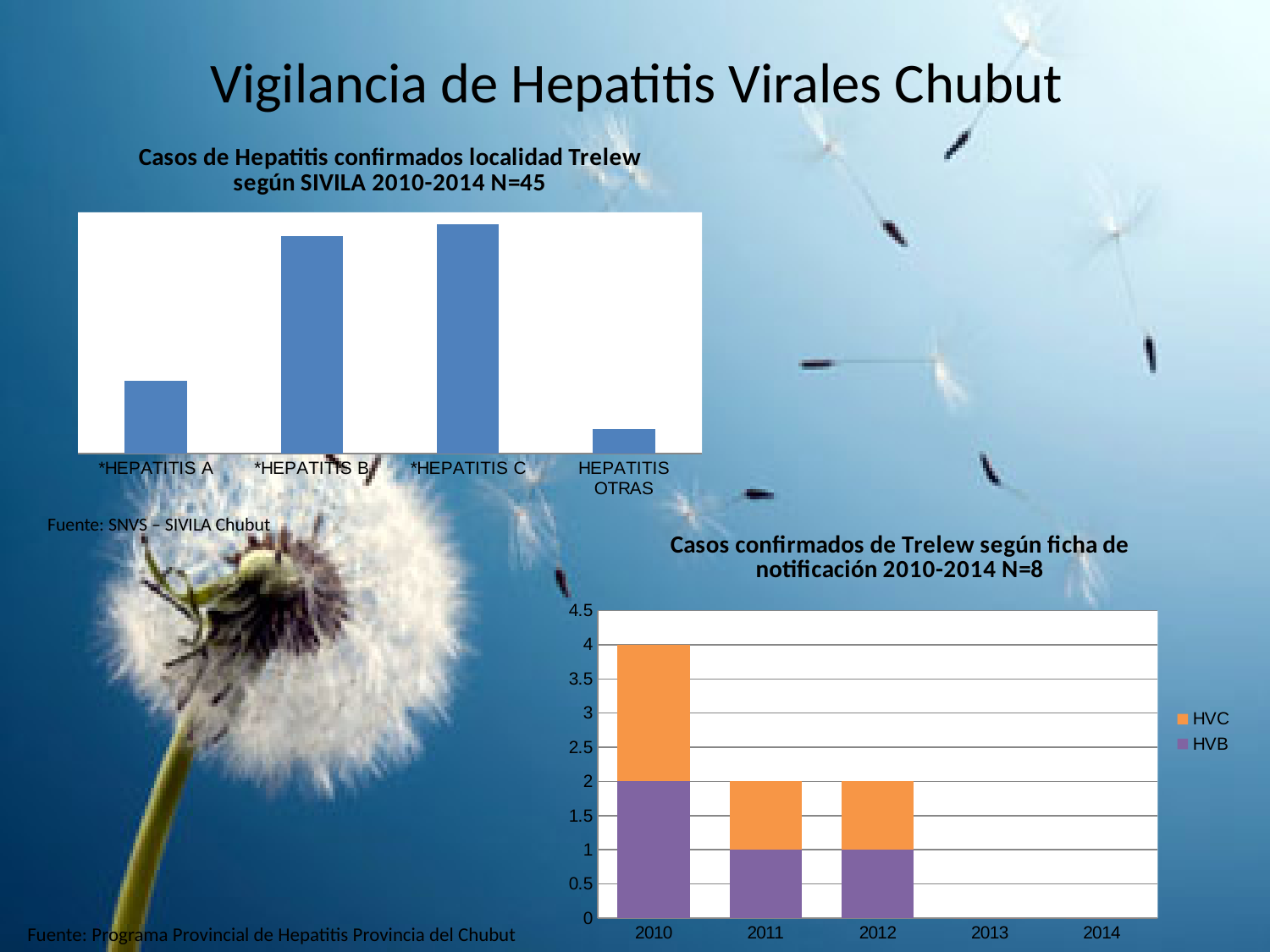
In the chart 'Casos confirmados de Trelew según ficha de notificación 2010-2014 N=8', what is the total of the stacked bar for 2012? 2 How many series does the legend list in the chart 'Casos confirmados de Trelew según ficha de notificación 2010-2014 N=8'? 2 In the chart 'Casos de Hepatitis confirmados localidad Trelew según SIVILA 2010-2014 N=45', which category has the lowest value? HEPATITIS OTRAS In the chart 'Casos de Hepatitis confirmados localidad Trelew según SIVILA 2010-2014 N=45', which category has the highest value? HEPATITIS C In the chart 'Casos confirmados de Trelew según ficha de notificación 2010-2014 N=8', what is the HVB value for 2010? 2 What type of chart is 'Casos de Hepatitis confirmados localidad Trelew según SIVILA 2010-2014 N=45'? Bar chart In the chart 'Casos confirmados de Trelew según ficha de notificación 2010-2014 N=8', which colour represents HVC? Orange In the chart 'Casos de Hepatitis confirmados localidad Trelew según SIVILA 2010-2014 N=45', which is larger, HEPATITIS A or HEPATITIS B? HEPATITIS B In the chart 'Casos confirmados de Trelew según ficha de notificación 2010-2014 N=8', what is the HVC value for 2011? 1 In the chart 'Casos confirmados de Trelew según ficha de notificación 2010-2014 N=8', what is the total of the stacked bar for 2010? 4 How many categories are shown in the chart 'Casos de Hepatitis confirmados localidad Trelew según SIVILA 2010-2014 N=45'? 4 In the chart 'Casos confirmados de Trelew según ficha de notificación 2010-2014 N=8', what is the difference between the total for 2010 and the total for 2011? 2